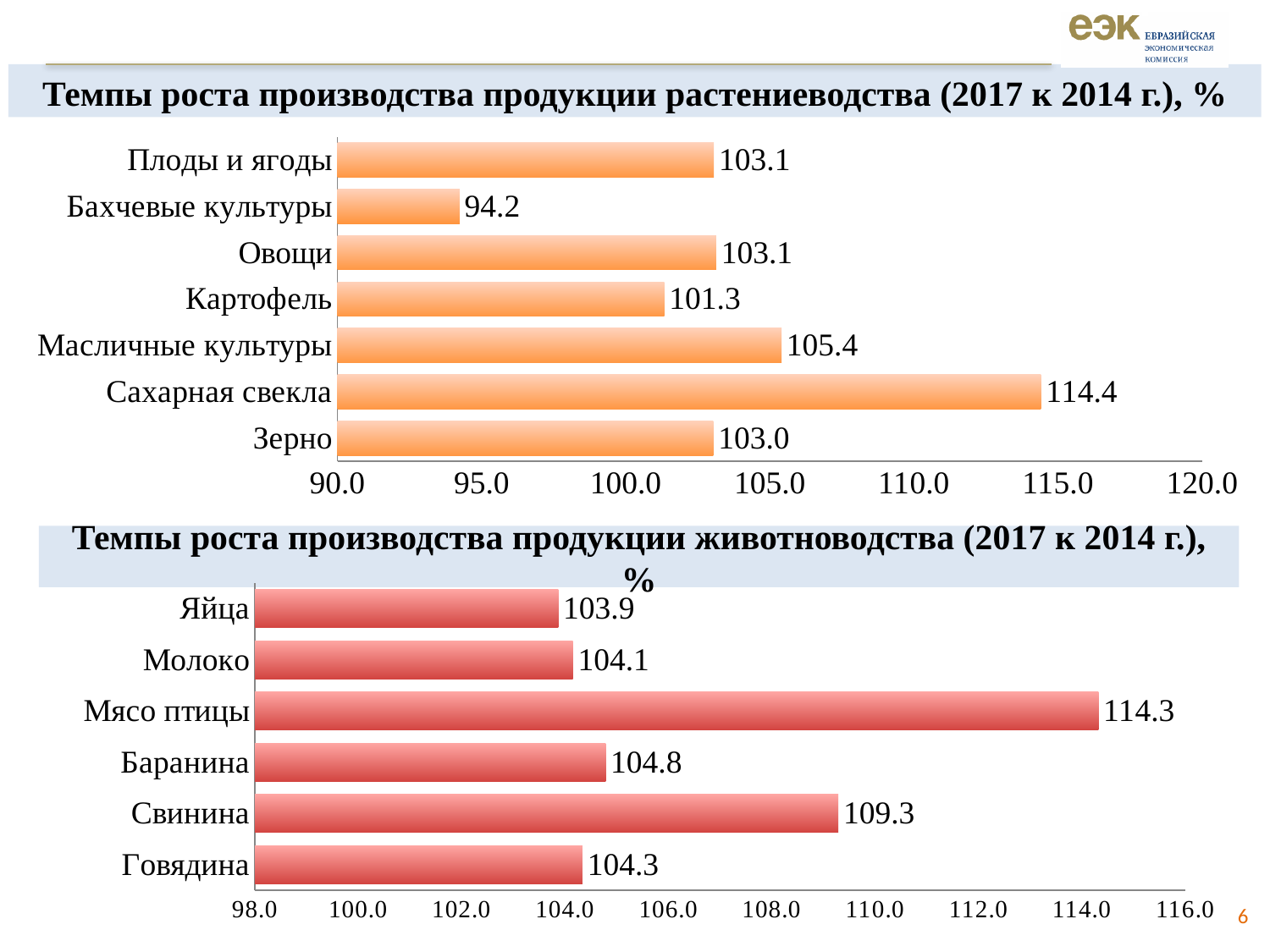
In the bottom chart (животноводство), which category has the highest value? Мясо птицы In the bottom chart (Темпы роста производства продукции животноводства), what is the value for Свинина? 109.3 In the bottom chart (животноводство), how many categories are shown? 6 What type of chart is the bottom chart (животноводство)? Bar chart In the top chart (растениеводство), what is the difference between Сахарная свекла and Бахчевые культуры? 20.2 In the bottom chart (животноводство), which category has the lowest value? Яйца In the top chart (Темпы роста производства продукции растениеводства), what is the value for Сахарная свекла? 114.4 In the top chart (растениеводство), how many categories are shown? 7 In the top chart (растениеводство), which category has the highest value? Сахарная свекла In the top chart (растениеводство), is the value for Бахчевые культуры greater or less than 100.0? less In the bottom chart (животноводство), which is larger, Свинина or Баранина? Свинина In the top chart (растениеводство), which category has the lowest value? Бахчевые культуры